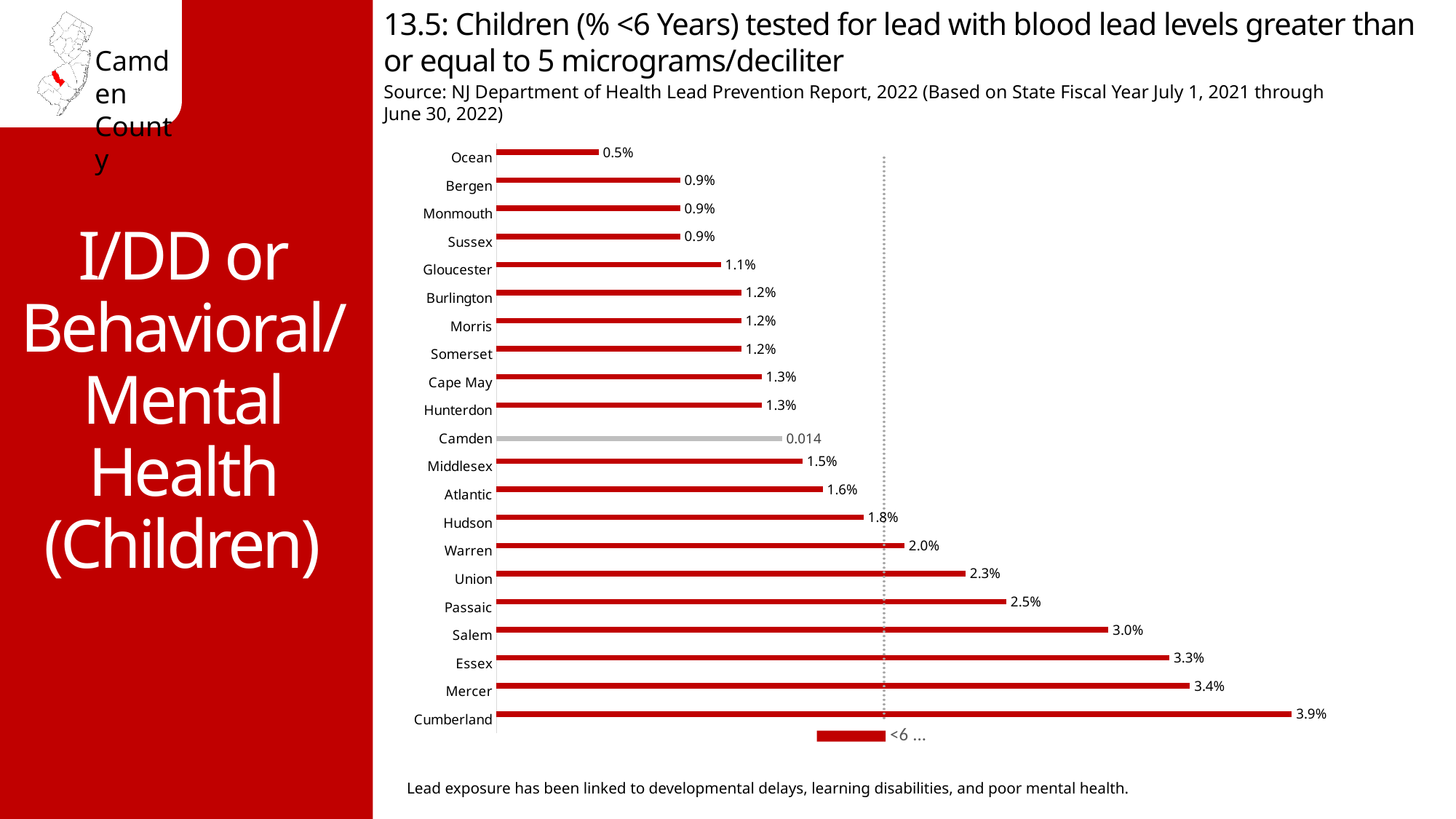
Which county's bar is colored grey instead of red? Camden Which has a larger value, Salem or Passaic? Salem What value is labeled on the Camden bar? 0.014 Which county has the highest value? Cumberland What is the difference between the values for Mercer and Essex? 0.1% How many counties are shown in the chart? 21 What kind of chart is shown on the slide? Bar chart What is the value for Hudson? 1.8% Which county has the lowest value? Ocean What is the value for Ocean? 0.5% What is the value for Cumberland? 3.9% Do the values increase or decrease going from the top bar (Ocean) to the bottom bar (Cumberland)? Increase